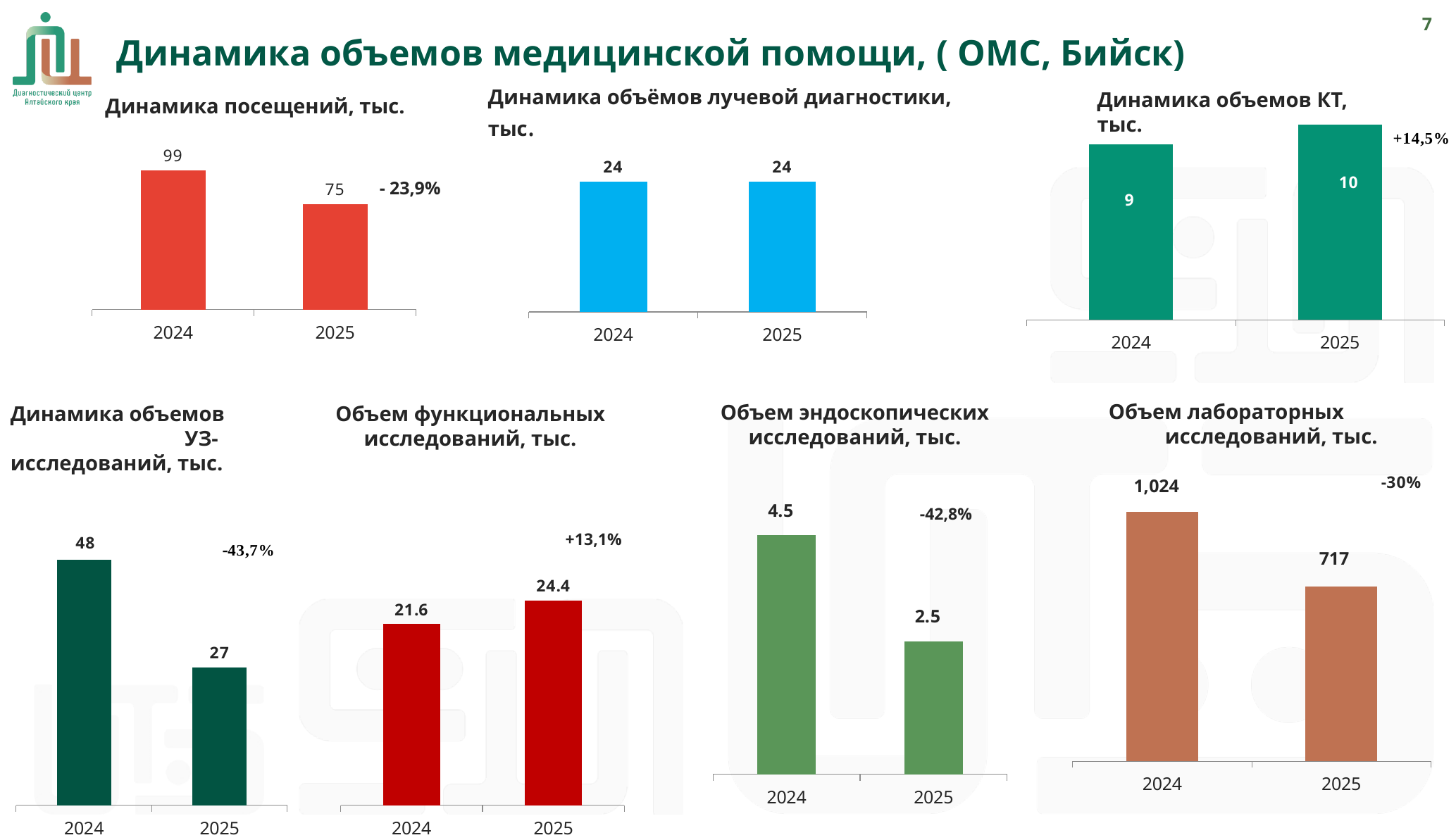
In the chart 'Динамика посещений, тыс.', what is the difference between the 2024 and 2025 values? 24 In the chart 'Динамика объемов УЗ-исследований, тыс.', what is the difference between the 2024 and 2025 values? 21 In the chart 'Динамика объемов КТ, тыс.', what is the value for 2025? 10 In the chart 'Объем эндоскопических исследований, тыс.', which year has the lower value? 2025 In the chart 'Динамика объемов УЗ-исследований, тыс.', what is the value for 2025? 27 How many bar charts are shown on the slide? 7 In the chart 'Объем лабораторных исследований, тыс.', what is the value for 2024? 1,024 In the chart 'Динамика посещений, тыс.', what is the value for 2024? 99 In the chart 'Объем функциональных исследований, тыс.', what is the value for 2024? 21.6 In the chart 'Динамика объемов КТ, тыс.', which year has the higher value? 2025 In the chart 'Динамика объёмов лучевой диагностики, тыс.', do the values rise, fall or stay the same from 2024 to 2025? stay the same In the chart 'Динамика объёмов лучевой диагностики, тыс.', what is the value for 2025? 24